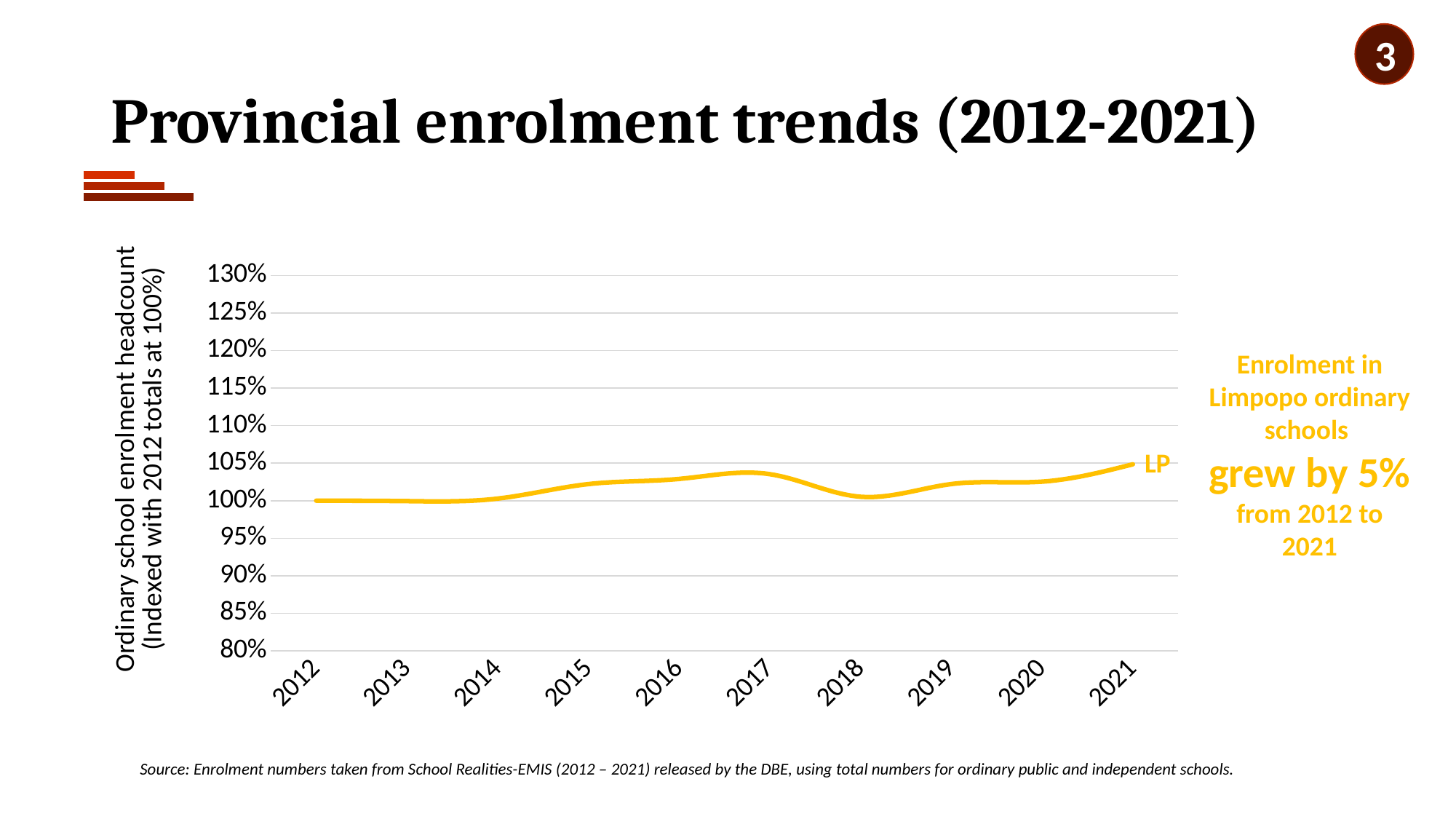
What kind of chart is shown on the slide? line chart What label is shown at the end of the line? LP Is the value for 2021 greater or less than 100%? greater Which year has the larger value, 2014 or 2017? 2017 Overall, does the line rise or fall from 2012 to 2021? rise How many series does the chart plot? 1 Is the value for 2017 greater or less than 100%? greater Which year has the larger value, 2016 or 2018? 2016 What is the indexed enrolment value for 2012? 100% What is the title of the chart's vertical axis? Ordinary school enrolment headcount (Indexed with 2012 totals at 100%) How many years are plotted along the x axis of the chart? 10 Is the value for 2017 greater or less than 105%? less